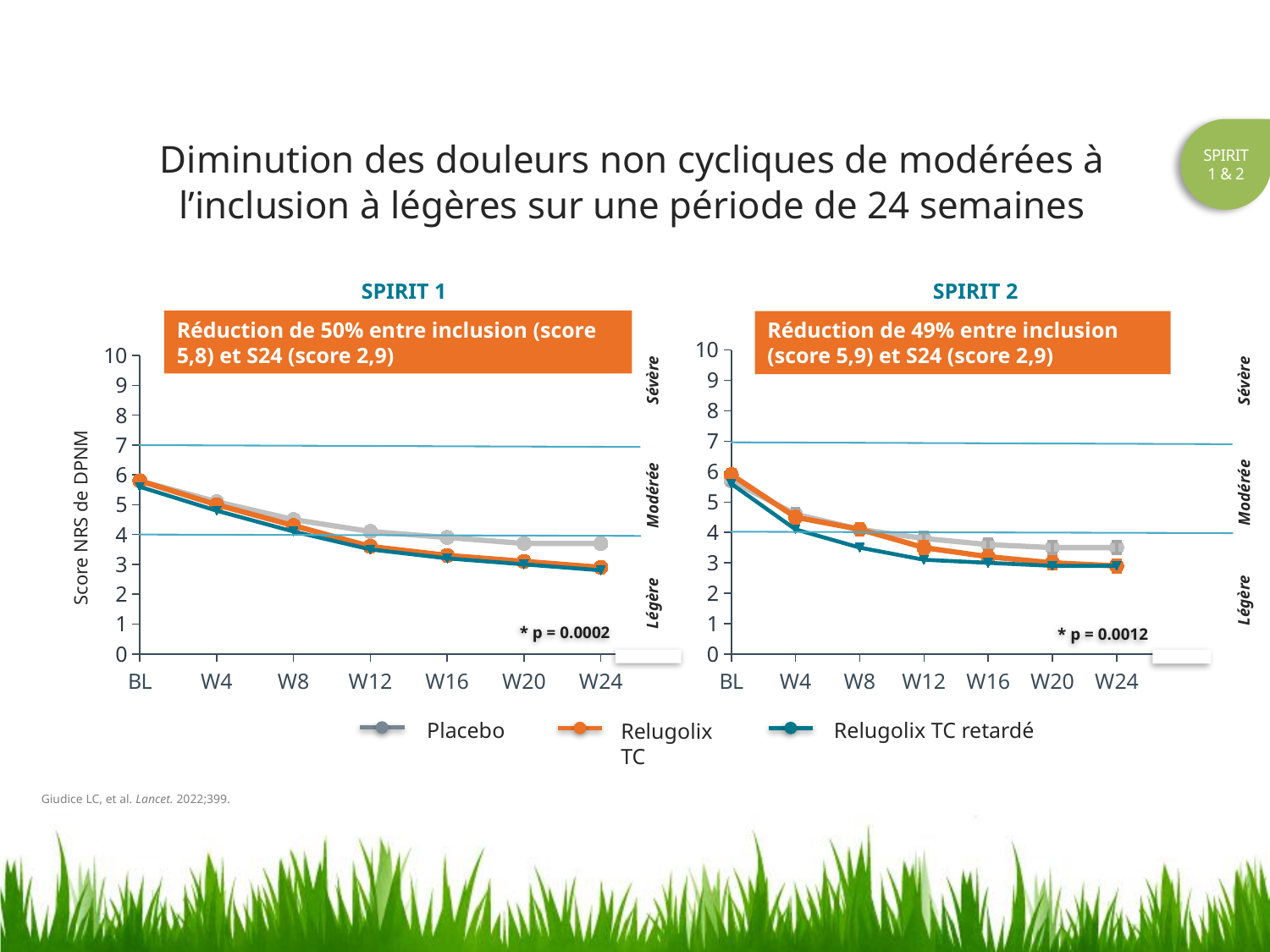
In the SPIRIT 1 chart, is the Placebo value at W24 greater or less than 4? less In the SPIRIT 1 chart, what is the difference between the inclusion score and the S24 score given in the annotation? 2,9 How many series does the legend list for the charts? 3 According to the annotation on the SPIRIT 1 chart, what is the score at inclusion? 5,8 What kind of chart is the SPIRIT 1 chart? line chart In the SPIRIT 2 chart, is the Relugolix TC value at BL greater or less than 5? greater According to the annotation on the SPIRIT 2 chart, what is the score at S24? 2,9 In the SPIRIT 1 chart, do the Relugolix TC values rise or fall from BL to W24? fall What p value is shown on the SPIRIT 2 chart? p = 0.0012 How many time points are plotted along the x axis of the SPIRIT 2 chart? 7 In the SPIRIT 1 chart, which series has the highest value at W24? Placebo According to the annotation on the SPIRIT 2 chart, what is the percentage reduction between inclusion and S24? 49%